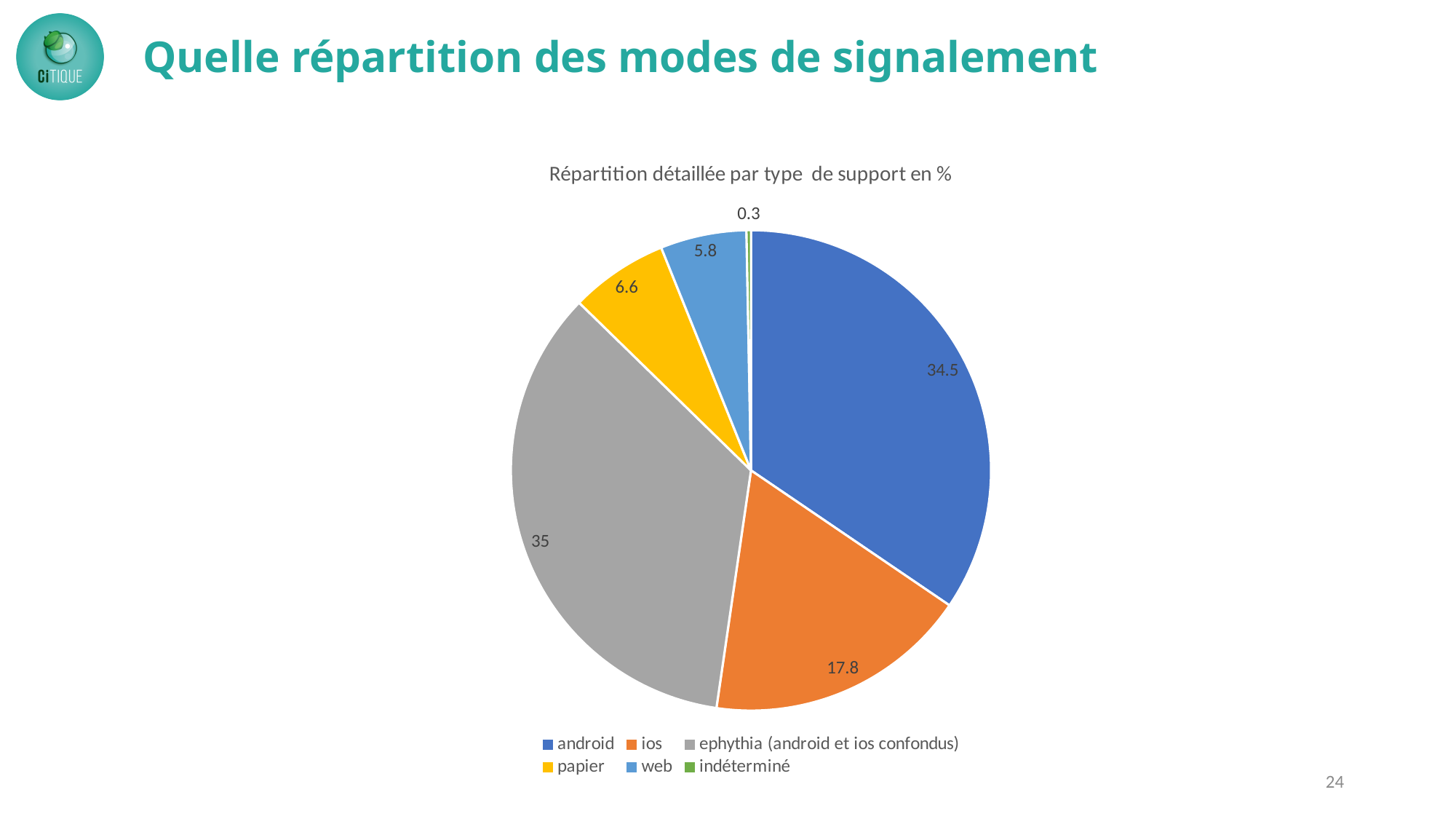
How many categories does the pie chart have? 6 What is the value for android? 34.5 What is the value for papier? 6.6 What is the difference between the values for android and ios? 16.7 What is the value for ios? 17.8 What type of chart is shown on the slide? Pie chart Which category has the smallest slice? indéterminé Which is larger, the value for papier or the value for web? papier What is the value for web? 5.8 Which category has the largest slice? ephythia (android et ios confondus) What is the title of the chart? Répartition détaillée par type de support en % What colour is the slice for ephythia (android et ios confondus)? Grey